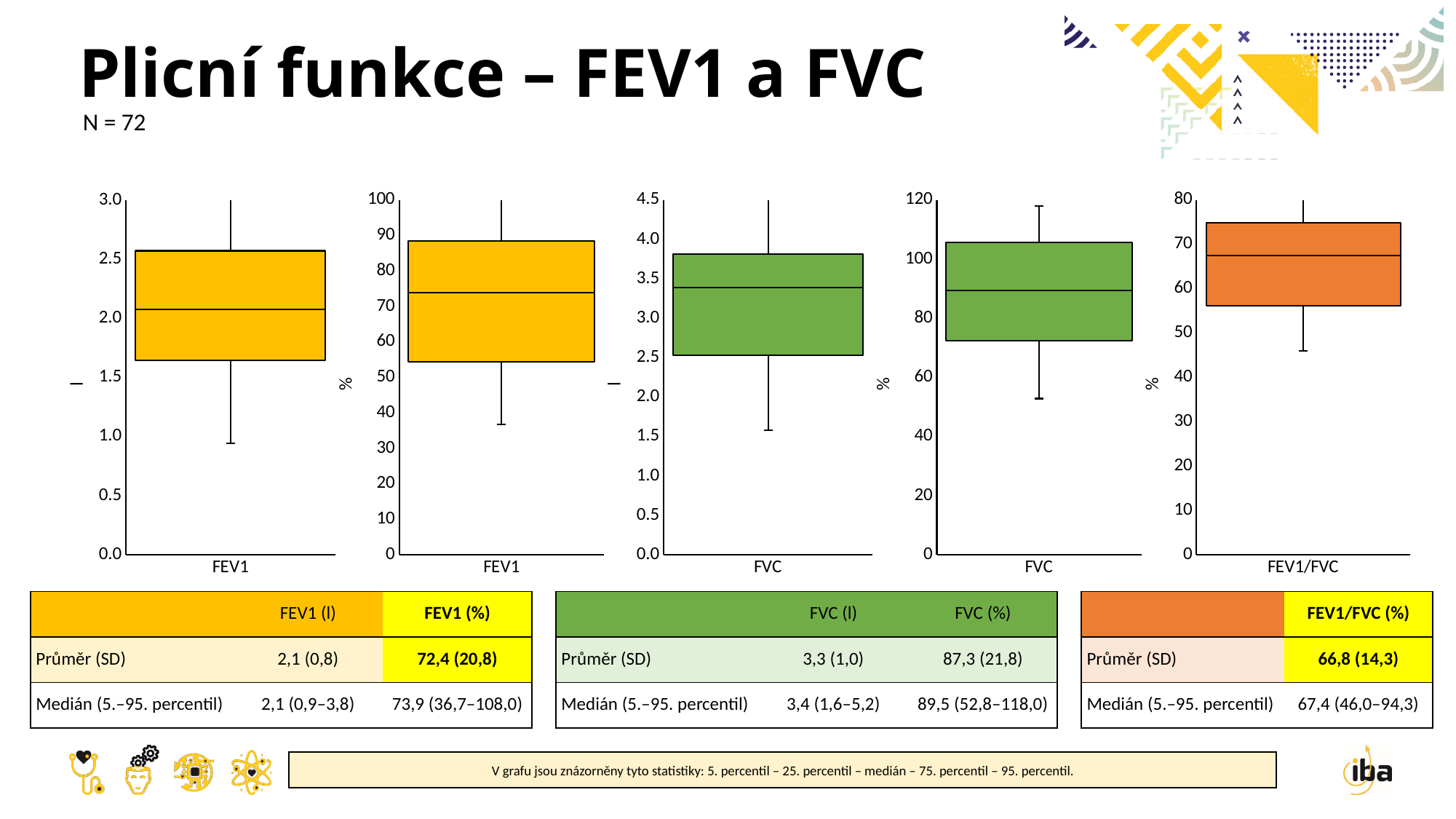
What is the sample size N stated on the slide? 72 What colour are the boxes in the two FVC charts? green In the leftmost FEV1 chart (litres), is the median line greater or less than 1.5? greater According to the table under the FEV1 charts, what is the median FEV1 in litres? 2,1 In the FVC chart with the % axis, is the bottom of the lower whisker greater or less than 60? less According to the table under the FEV1/FVC chart, what is the mean (SD) of FEV1/FVC (%)? 66,8 (14,3) What kind of chart is used for the leftmost FEV1 chart? box plot In the FVC chart with the litres axis, is the top of the upper whisker greater or less than 4.0? greater How many box plot charts are shown on the slide? 5 Is the median in the FVC (%) chart higher or lower than the median in the FEV1 (%) chart? higher